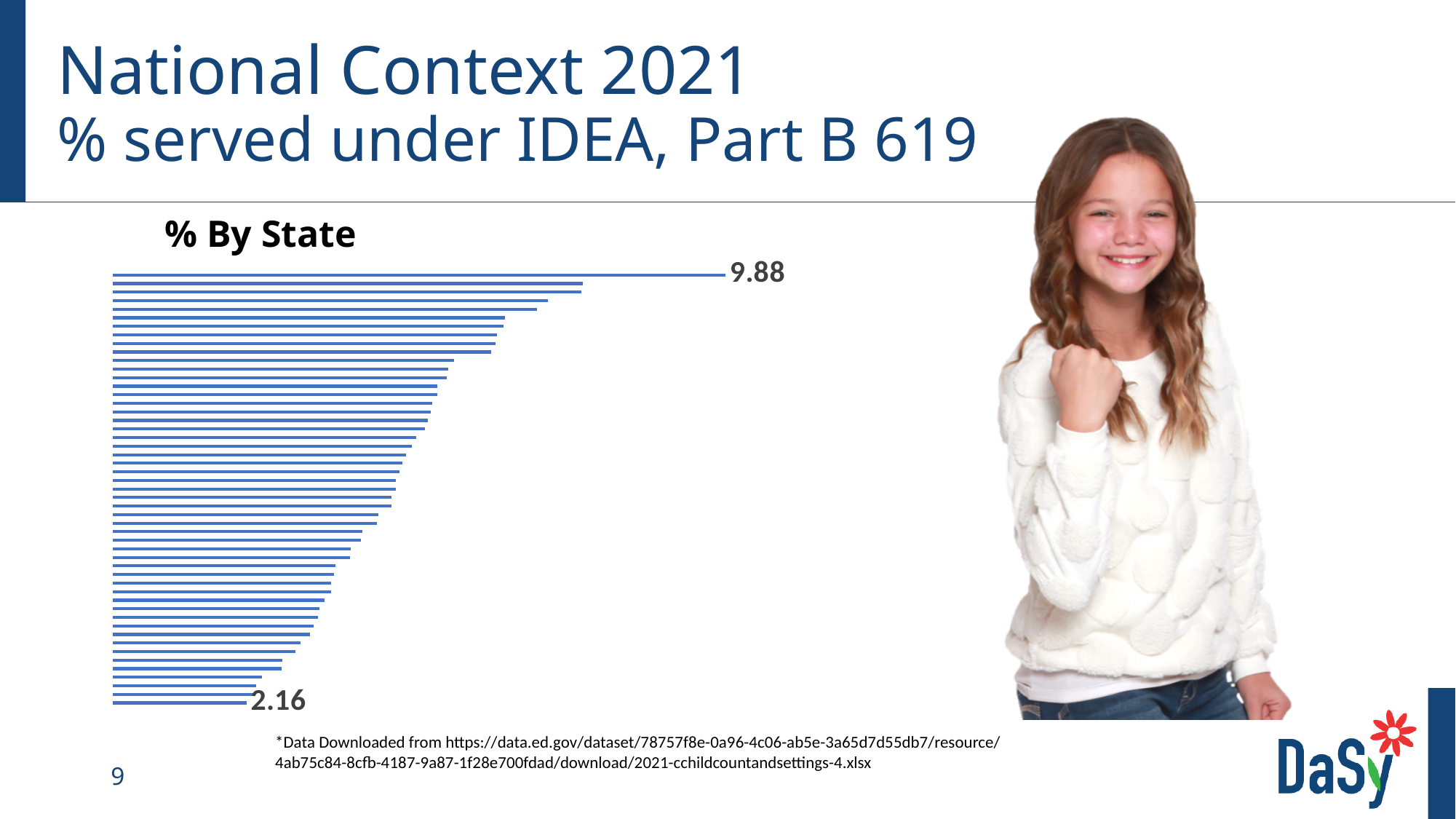
What is the difference between the highest labelled value and the lowest labelled value in the chart? 7.72 How many bars in the chart have a printed data label? 2 What is the title of the chart? % By State What is the value labelled on the shortest bar in the chart? 2.16 Do the bar lengths increase or decrease from the top of the chart to the bottom? decrease What kind of chart is shown on the slide? bar chart What is the value labelled on the longest bar in the chart? 9.88 Is the value of the top bar greater or less than 5? greater Is the value of the bottom bar greater or less than 5? less Which is larger, the value of the top bar or the value of the bottom bar? the top bar